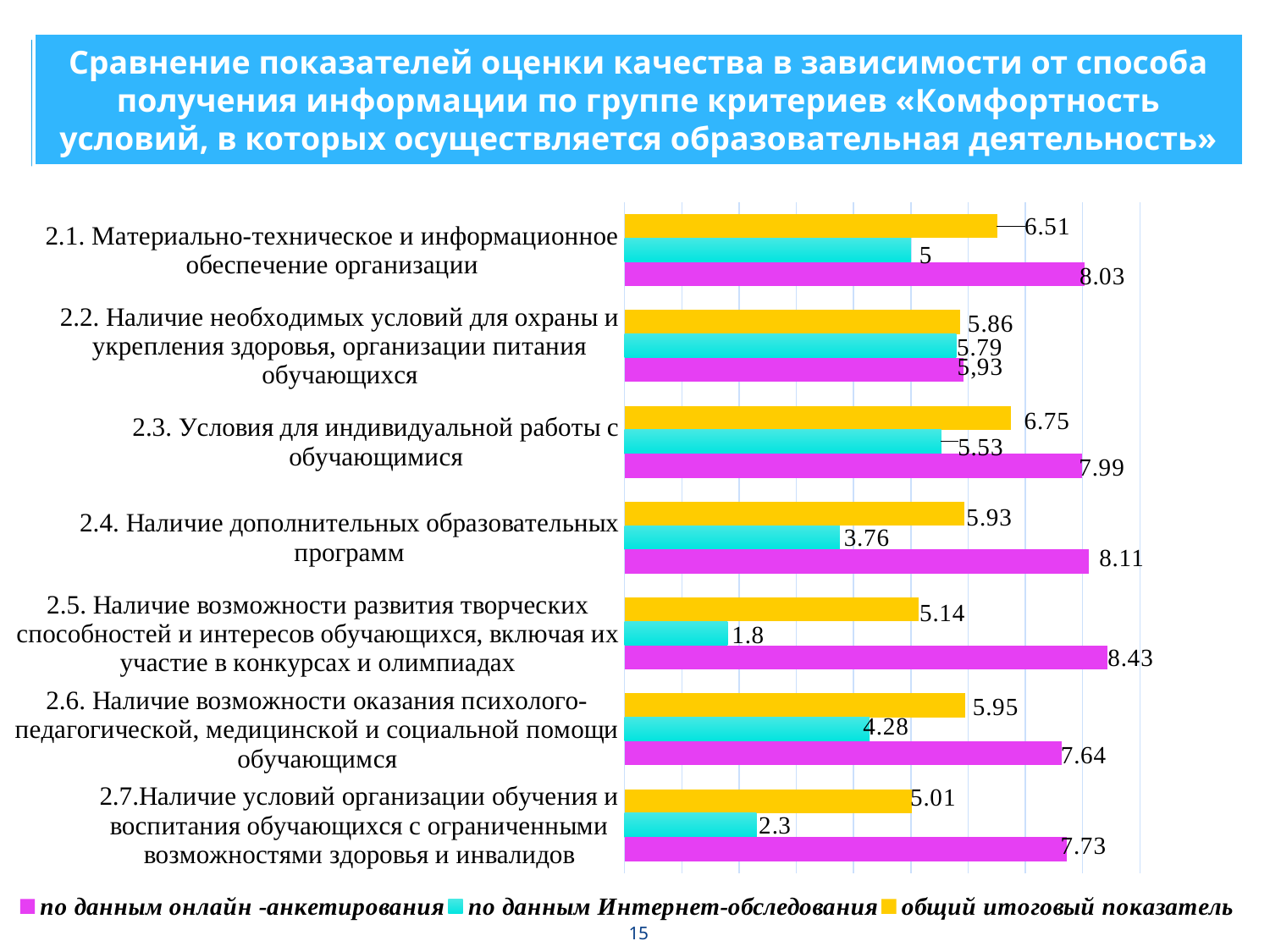
What is the difference between the "по данным онлайн -анкетирования" value and the "по данным Интернет-обследования" value for category 2.1 (Материально-техническое и информационное обеспечение организации)? 3.03 Which category has the highest value for "по данным онлайн -анкетирования"? 2.5. Наличие возможности развития творческих способностей и интересов обучающихся, включая их участие в конкурсах и олимпиадах How many categories are shown on the chart? 7 Which category has the lowest value for "по данным Интернет-обследования"? 2.5. Наличие возможности развития творческих способностей и интересов обучающихся, включая их участие в конкурсах и олимпиадах What is the value for "по данным онлайн -анкетирования" for category 2.5 (Наличие возможности развития творческих способностей и интересов обучающихся)? 8.43 Which colour represents the series "по данным Интернет-обследования" in the legend? Cyan Which category has the highest "общий итоговый показатель" value? 2.3. Условия для индивидуальной работы с обучающимися How many series does the legend list? 3 What is the "общий итоговый показатель" value for category 2.3 (Условия для индивидуальной работы с обучающимися)? 6.75 What kind of chart is shown on the slide? Bar chart What is the value for "по данным Интернет-обследования" for category 2.4 (Наличие дополнительных образовательных программ)? 3.76 For category 2.7 (Наличие условий организации обучения и воспитания обучающихся с ограниченными возможностями здоровья и инвалидов), which is larger: the "общий итоговый показатель" value or the "по данным Интернет-обследования" value? общий итоговый показатель